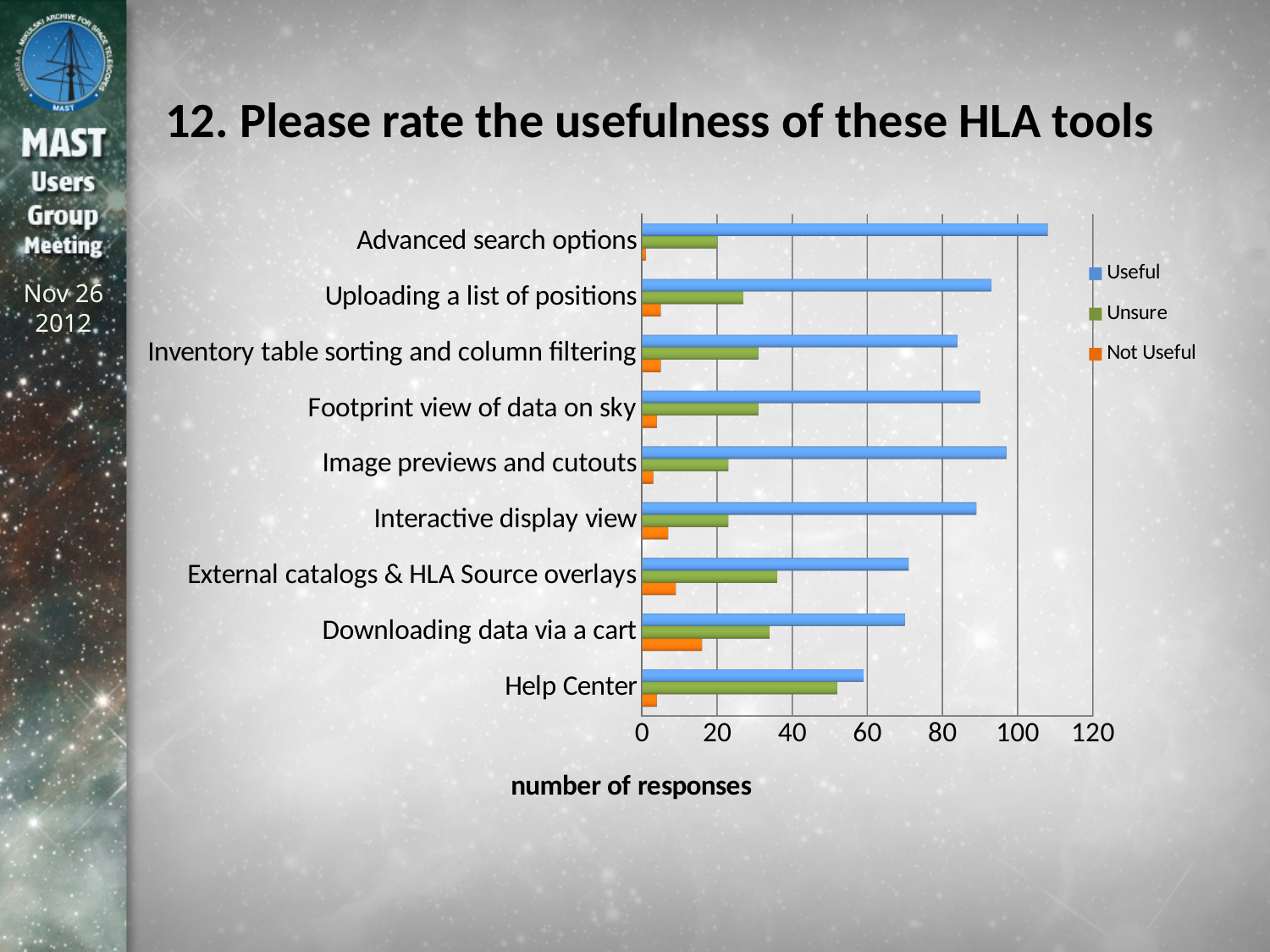
What kind of chart is shown on the slide? bar chart Is the 'Useful' value for External catalogs & HLA Source overlays greater or less than 80? less How many HLA tools (categories) are listed on the chart? 9 Which has more 'Useful' responses: Uploading a list of positions or Inventory table sorting and column filtering? Uploading a list of positions How many series does the legend list? 3 Is the 'Useful' value for Advanced search options greater or less than 100? greater Which tool has the highest number of 'Not Useful' responses? Downloading data via a cart Which tool has the lowest number of 'Useful' responses? Help Center Which tool has the highest number of 'Unsure' responses? Help Center Which tool has the highest number of 'Useful' responses? Advanced search options What is the title of the horizontal axis? number of responses Is the 'Unsure' value for Help Center greater or less than 40? greater